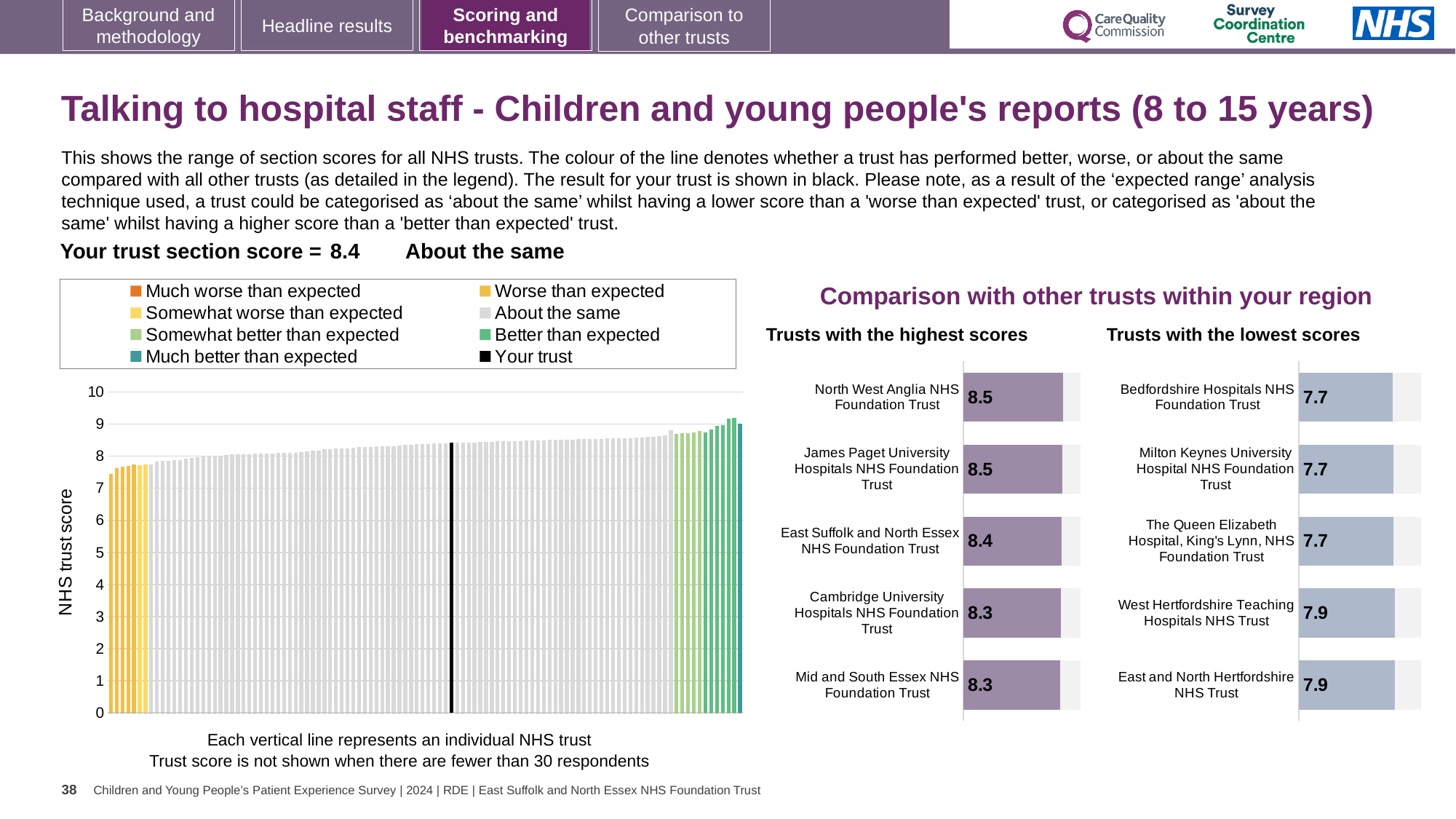
Which is larger: the score for East Suffolk and North Essex NHS Foundation Trust in the 'highest scores' chart or the score for West Hertfordshire Teaching Hospitals NHS Trust in the 'lowest scores' chart? East Suffolk and North Essex NHS Foundation Trust In the 'Trusts with the lowest scores' chart, what is the score for Bedfordshire Hospitals NHS Foundation Trust? 7.7 How many trusts are listed in the 'Trusts with the lowest scores' chart? 5 In the 'Trusts with the lowest scores' chart, what is the difference between the scores of East and North Hertfordshire NHS Trust and Milton Keynes University Hospital NHS Foundation Trust? 0.2 In the large chart on the left, is the value of the black bar (your trust) greater or less than 8? greater What kind of chart is the large chart on the left showing NHS trust scores? Bar chart In the 'Trusts with the highest scores' chart, what is the difference between the scores of North West Anglia NHS Foundation Trust and Mid and South Essex NHS Foundation Trust? 0.2 In the 'Trusts with the highest scores' chart, what is the score for North West Anglia NHS Foundation Trust? 8.5 How many entries does the legend above the large chart on the left list? 8 In the 'Trusts with the lowest scores' chart, what is the score for West Hertfordshire Teaching Hospitals NHS Trust? 7.9 How many trusts are listed in the 'Trusts with the highest scores' chart? 5 In the 'Trusts with the highest scores' chart, what is the score for Cambridge University Hospitals NHS Foundation Trust? 8.3